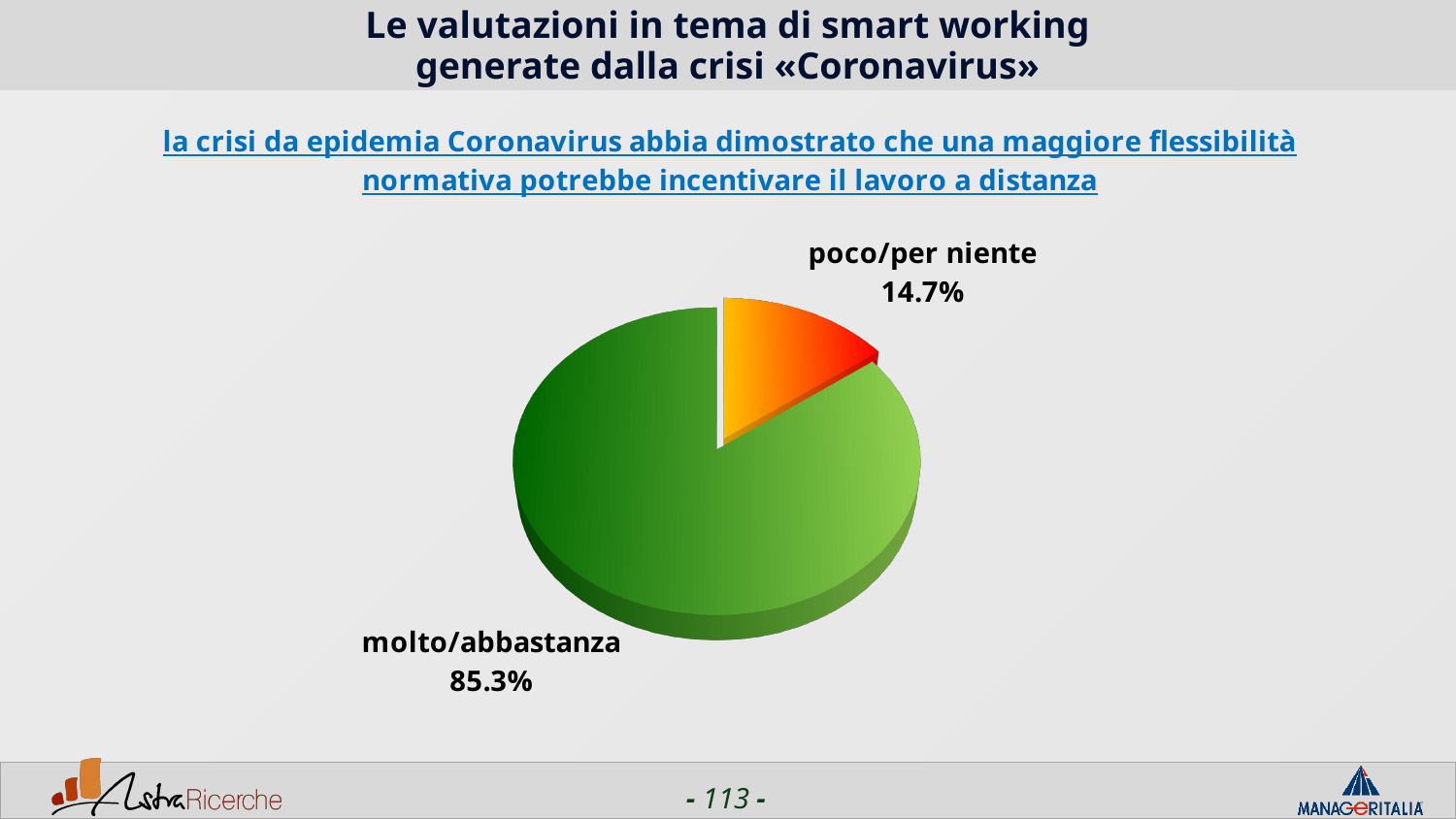
What colour is the "poco/per niente" slice? orange/red How many slices does the pie chart have? 2 What kind of chart is shown on the slide? pie chart What is the difference in percentage points between "molto/abbastanza" and "poco/per niente"? 70.6 Which is larger, the share for "molto/abbastanza" or for "poco/per niente"? molto/abbastanza What is the total of the two percentages shown on the pie chart? 100% Which slice of the pie is the largest? molto/abbastanza What colour is the "molto/abbastanza" slice? green Which slice of the pie is the smallest? poco/per niente What percentage is shown for "molto/abbastanza"? 85.3% What percentage is shown for "poco/per niente"? 14.7%